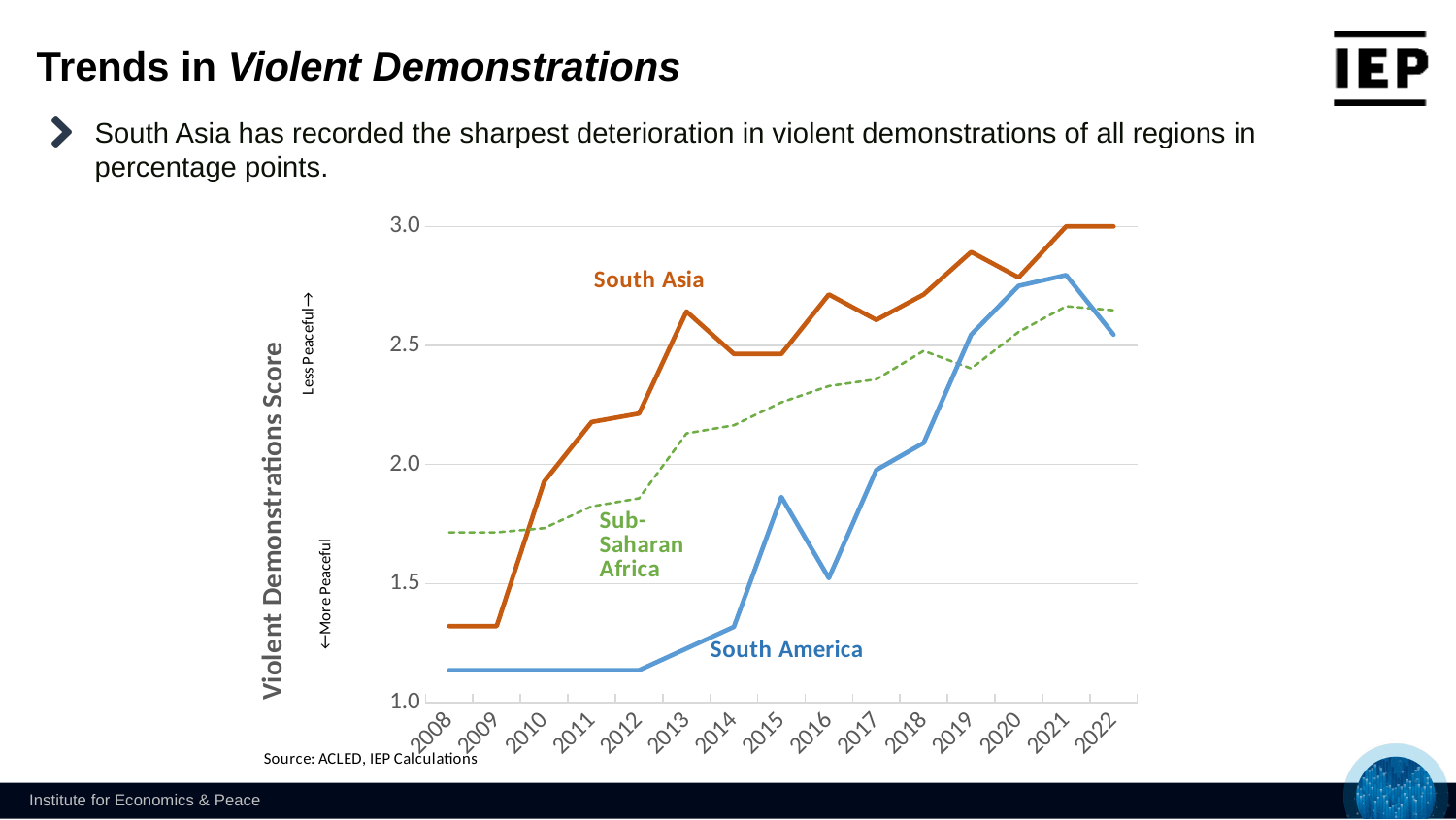
Is the value for South America in 2021 greater or less than 2.5? greater Which region has the lowest Violent Demonstrations Score in 2008? South America Does the South Asia line generally rise or fall from 2008 to 2022? rise What is the title of the chart's y axis? Violent Demonstrations Score In 2016, which region has the larger Violent Demonstrations Score, South Asia or South America? South Asia Is the value for South Asia in 2013 greater or less than 2.5? greater Is the value for Sub-Saharan Africa in 2008 greater or less than 2.0? less Which region has the highest Violent Demonstrations Score in 2022? South Asia What kind of chart is shown on the slide? line chart How many regions (series) are plotted on the chart? 3 How many years are shown along the x axis of the chart? 15